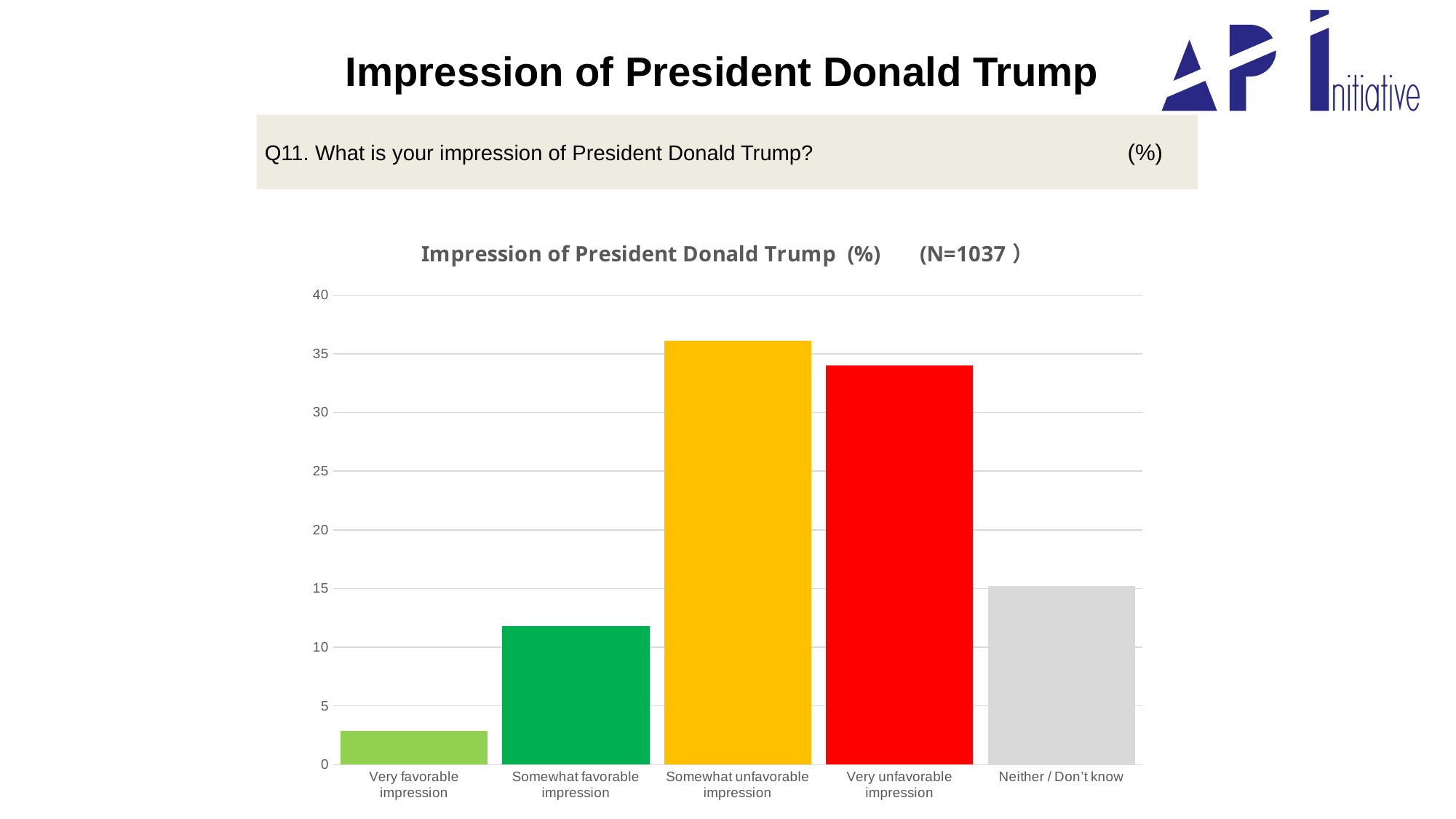
Which category has the highest value in the chart? Somewhat unfavorable impression Is the value for Somewhat favorable impression greater or less than 10? greater What sample size (N) is stated in the chart title? N=1037 Which category has the lowest value in the chart? Very favorable impression Is the value for Neither / Don't know greater or less than 20? less Which is larger, the value for Very unfavorable impression or the value for Neither / Don't know? Very unfavorable impression What kind of chart is shown on the slide? bar chart Is the value for Very unfavorable impression greater or less than 35? less How many categories are shown on the x axis of the chart? 5 Which is larger, the value for Somewhat favorable impression or the value for Neither / Don't know? Neither / Don't know